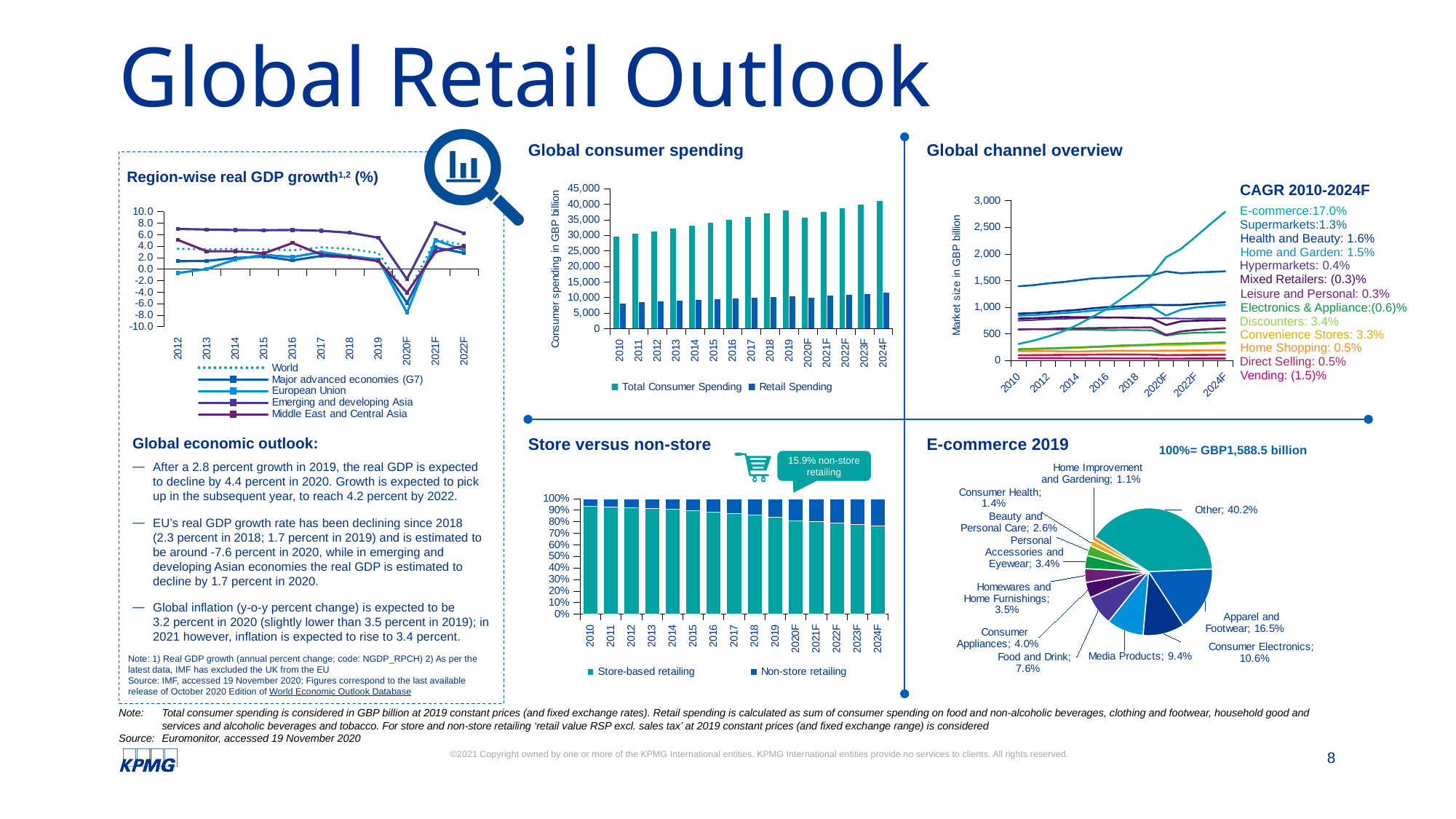
In the E-commerce 2019 pie chart, what share does Apparel and Footwear have? 16.5% In the E-commerce 2019 pie chart, which category has the smallest slice? Home Improvement and Gardening In the Global consumer spending chart, is the Retail Spending value for 2010 greater or less than 10,000? less How many series does the legend of the Region-wise real GDP growth chart list? 5 In the E-commerce 2019 pie chart, which category has the largest slice? Other How many years are shown on the x axis of the Global consumer spending chart? 15 What kind of chart is the Global consumer spending chart? bar chart In the Global consumer spending chart, does Total Consumer Spending generally rise or fall from 2010 to 2024F? rise In the Global channel overview chart, which channel has the highest CAGR 2010-2024F? E-commerce (17.0%) What total value does the E-commerce 2019 pie chart say 100% corresponds to? GBP1,588.5 billion In the E-commerce 2019 pie chart, what is the difference in percentage points between Apparel and Footwear and Consumer Electronics? 5.9 In the E-commerce 2019 pie chart, which is larger: Media Products or Food and Drink? Media Products